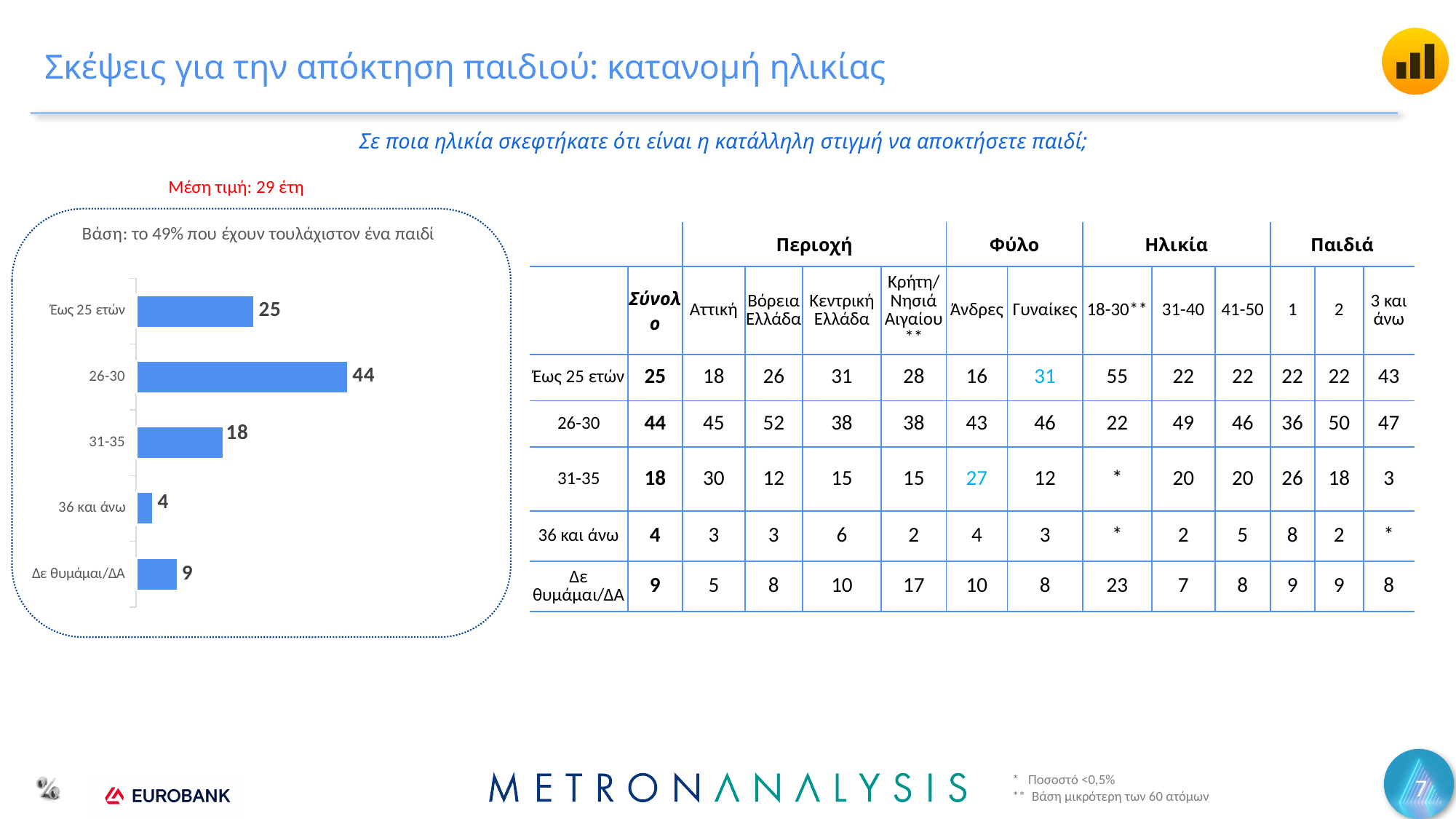
How many categories are shown in the bar chart? 5 What mean value (Μέση τιμή) is stated above the bar chart? 29 έτη Which is larger in the bar chart: 'Έως 25 ετών' or '31-35'? Έως 25 ετών What is the value for '36 και άνω' in the bar chart? 4 What is the value for the '26-30' category in the bar chart? 44 What is the difference between the values for 'Δε θυμάμαι/ΔΑ' and '36 και άνω' in the bar chart? 5 What is the value for 'Έως 25 ετών' in the bar chart? 25 What type of chart is shown on the left of the slide? Bar chart What is the difference between the values for '26-30' and '31-35' in the bar chart? 26 Which category has the lowest value in the bar chart? 36 και άνω What is the value for 'Δε θυμάμαι/ΔΑ' in the bar chart? 9 Which category has the highest value in the bar chart? 26-30